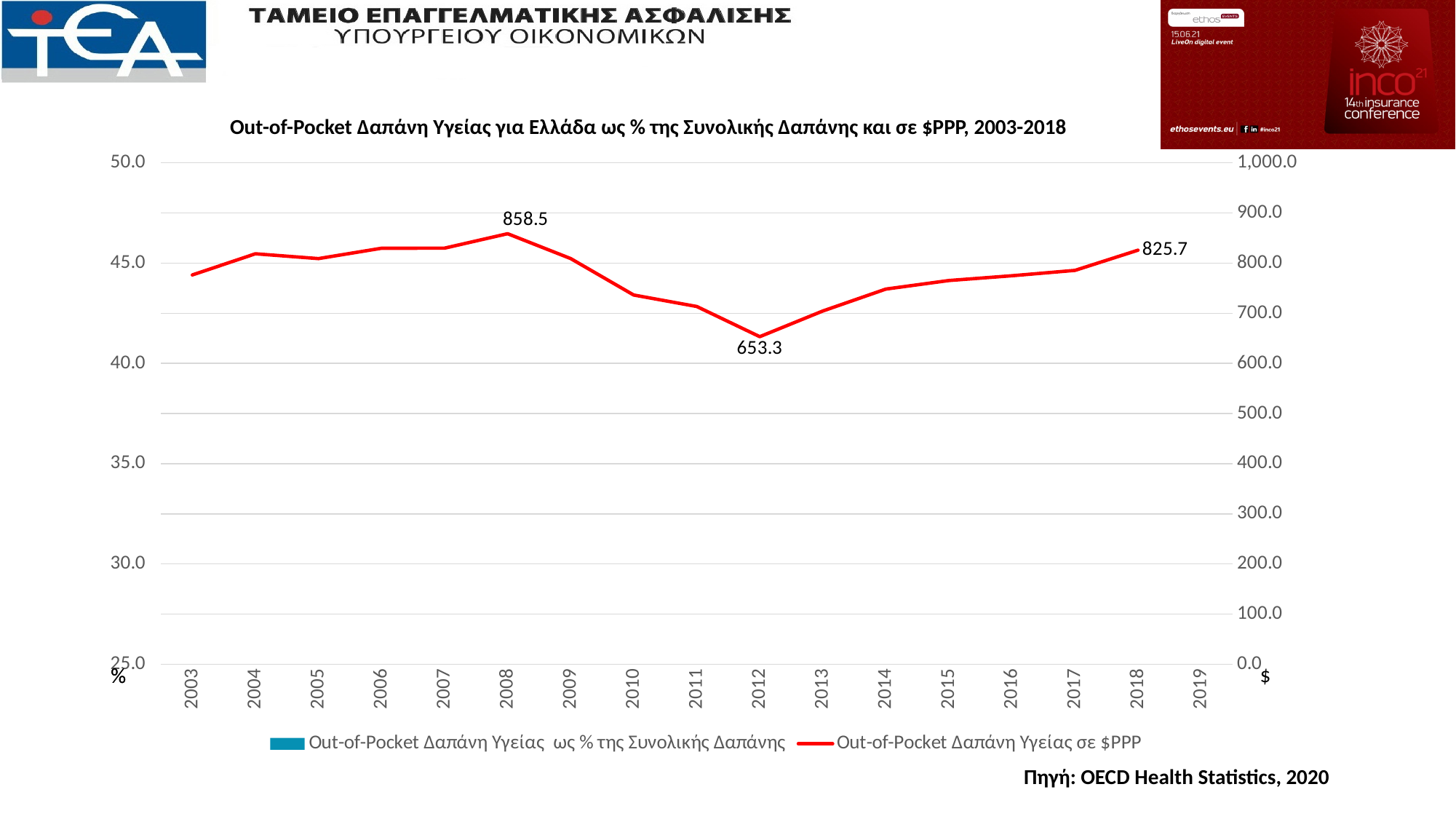
Is the Out-of-Pocket expenditure in $PPP for 2003 greater or less than 700.0? greater Which year has the larger Out-of-Pocket expenditure in $PPP, 2008 or 2018? 2008 What is the Out-of-Pocket health expenditure in $PPP for 2018? 825.7 What is the Out-of-Pocket health expenditure in $PPP for 2012? 653.3 In which year does the Out-of-Pocket expenditure in $PPP line reach its lowest point? 2012 How many series does the legend list? 2 What is the difference between the 2008 and 2012 values of Out-of-Pocket expenditure in $PPP? 205.2 What kind of chart is shown on the slide? Line chart What is the Out-of-Pocket health expenditure in $PPP for 2008? 858.5 What is the difference between the 2018 and 2012 values of Out-of-Pocket expenditure in $PPP? 172.4 In which year does the Out-of-Pocket expenditure in $PPP line reach its highest point? 2008 Is the Out-of-Pocket expenditure in $PPP for 2010 greater or less than 800.0? less